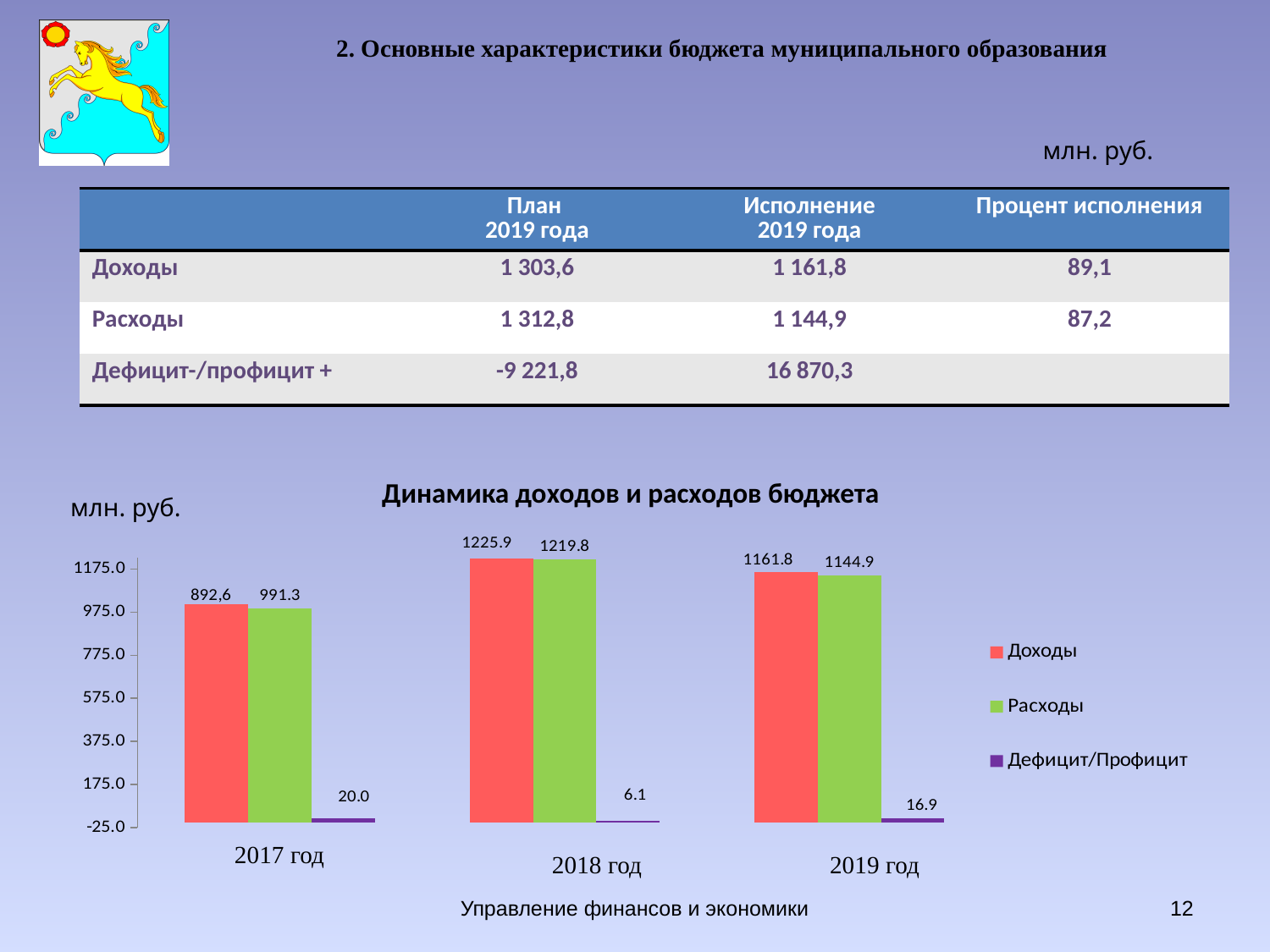
In the chart 'Динамика доходов и расходов бюджета', what is the difference between Доходы and Расходы for 2019 год? 16.9 How many years are shown on the x axis of the chart 'Динамика доходов и расходов бюджета'? 3 How many series does the legend of the chart 'Динамика доходов и расходов бюджета' list? 3 In the chart 'Динамика доходов и расходов бюджета', what is the value of Расходы for 2019 год? 1144.9 What kind of chart is 'Динамика доходов и расходов бюджета'? bar chart In the chart 'Динамика доходов и расходов бюджета', which year has the highest value of Доходы? 2018 год In the chart 'Динамика доходов и расходов бюджета', which year has the lowest value of Дефицит/Профицит? 2018 год In the chart 'Динамика доходов и расходов бюджета', what is the value of Доходы for 2018 год? 1225.9 In the chart 'Динамика доходов и расходов бюджета', what is the value of Доходы for 2017 год? 892,6 In the chart 'Динамика доходов и расходов бюджета', is the value of Расходы for 2018 год greater or less than 1175.0? greater In the chart 'Динамика доходов и расходов бюджета', what is the value of Дефицит/Профицит for 2017 год? 20.0